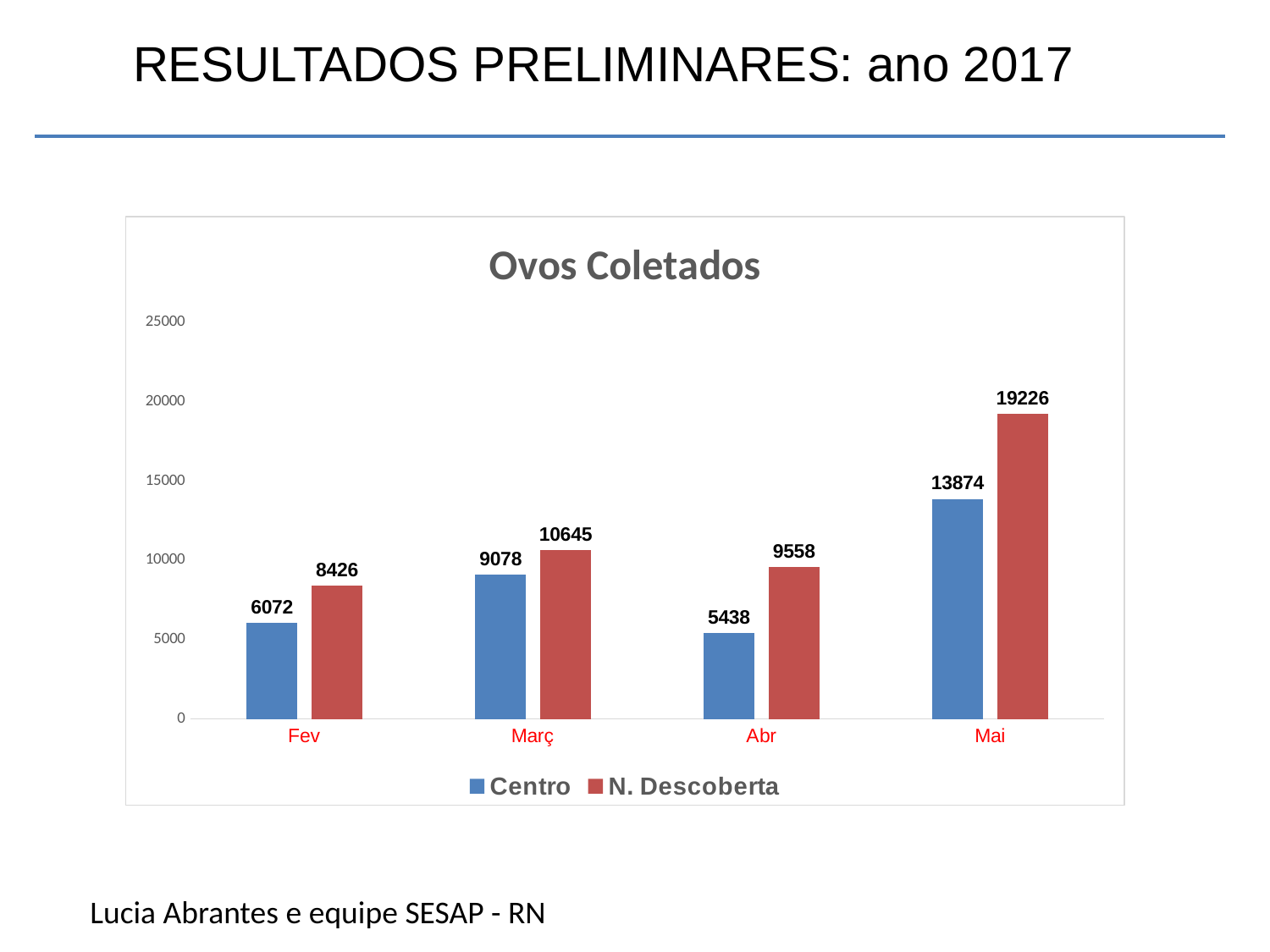
In which month is the Centro value highest? Mai What is the difference between the Centro values for Març and Fev? 3006 How many series does the legend list? 2 What is the value for N. Descoberta in Abr? 9558 Is the value for N. Descoberta in Fev greater or less than 10000? less In which month is the Centro value lowest? Abr What kind of chart is shown? bar chart What is the difference between N. Descoberta and Centro in Mai? 5352 What is the value for Centro in Fev? 6072 Which is larger in Març, Centro or N. Descoberta? N. Descoberta How many months are shown on the x axis? 4 What is the value for N. Descoberta in Mai? 19226